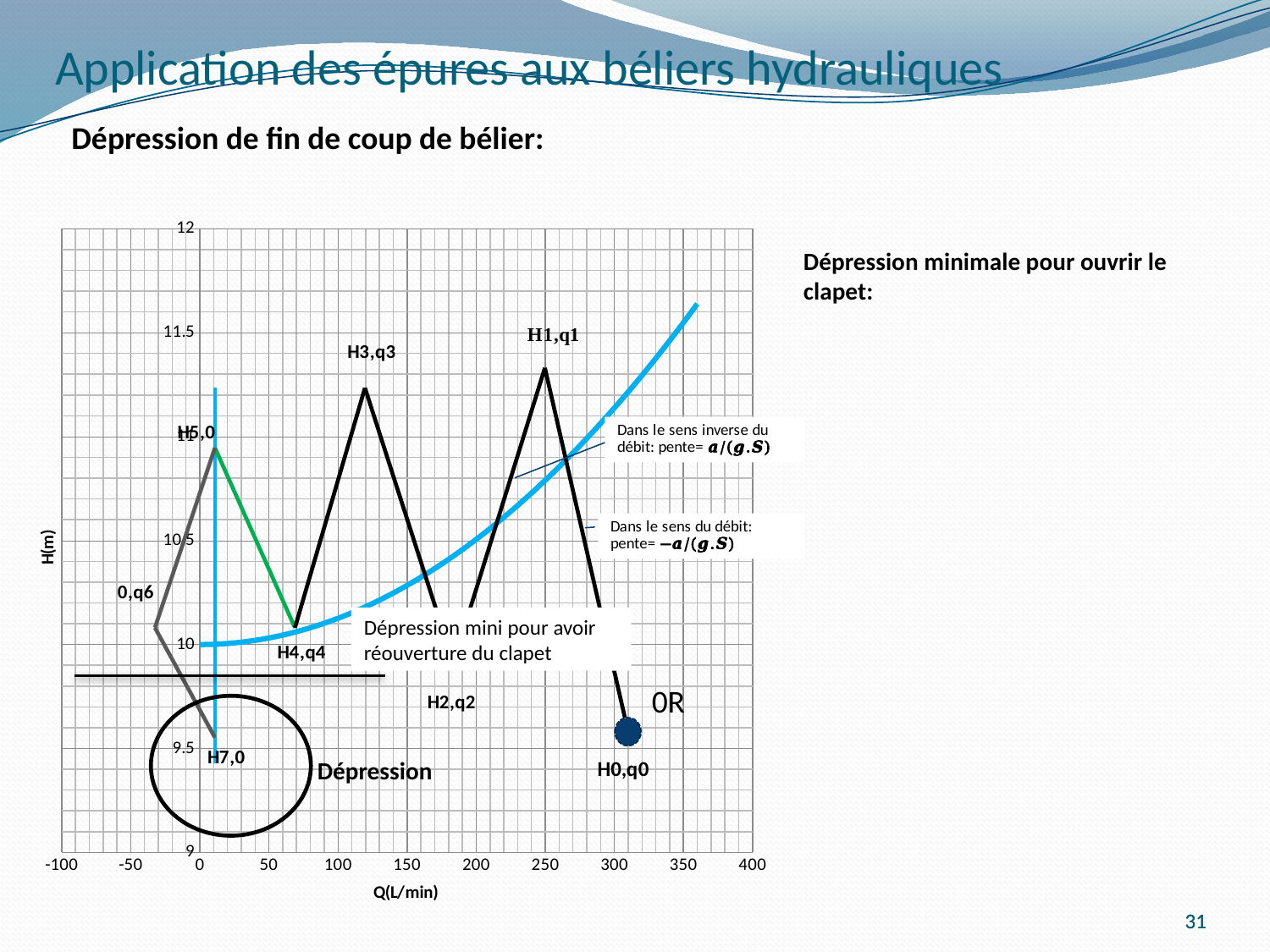
Does the thick blue curve rise or fall as Q increases? rise Which point has the larger Q value, H0,q0 or H4,q4? H0,q0 Is the H value of the point labelled H0,q0 greater or less than 10? less Which point has the higher H value, H1,q1 or H0,q0? H1,q1 What is the title of the horizontal axis of the chart? Q(L/min) Is the H value of the point labelled H7,0 greater or less than 10? less Is the H value of the point labelled H3,q3 greater or less than 11? greater What is the title of the vertical axis of the chart? H(m) What kind of chart is shown on the slide? line chart